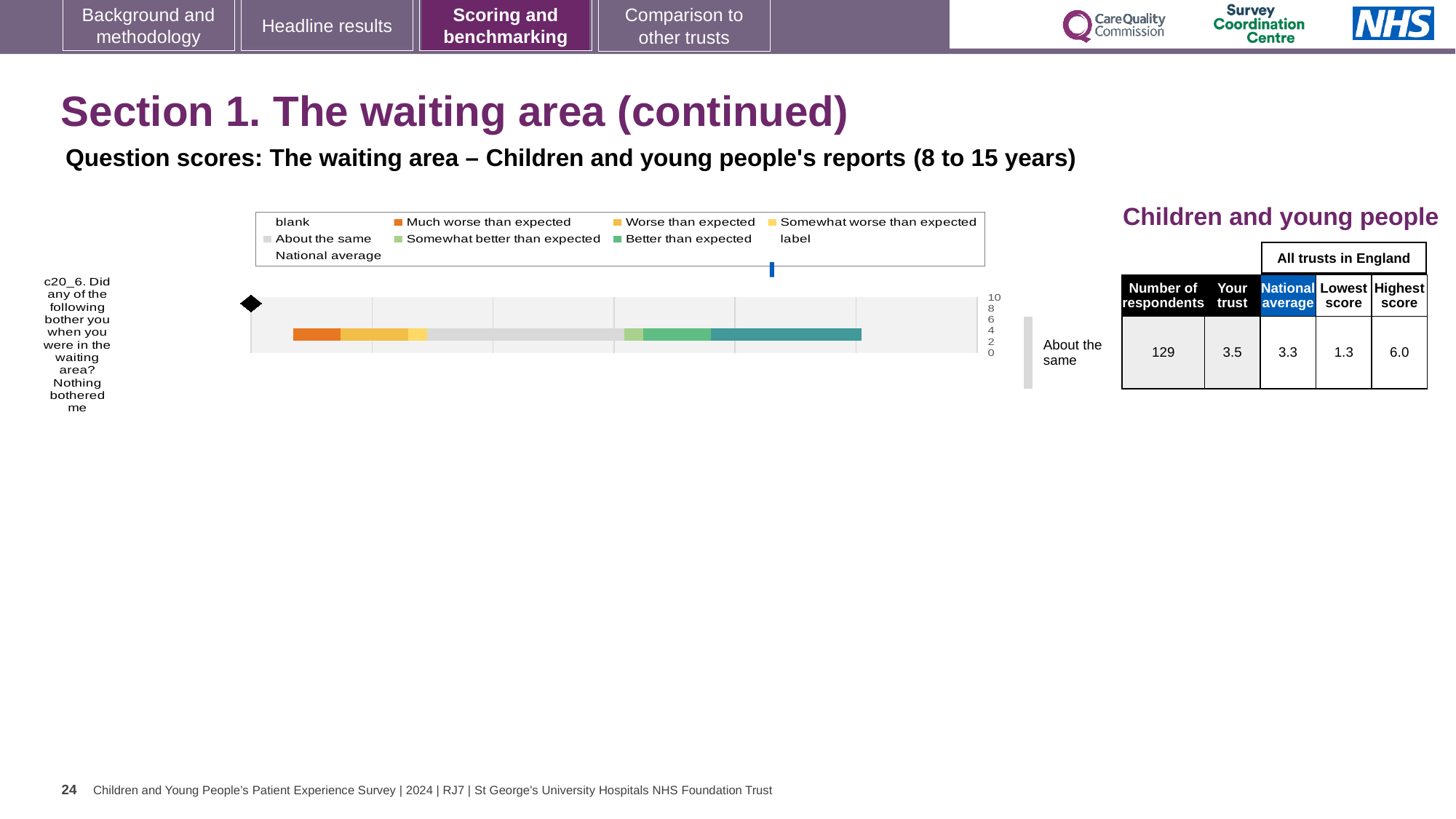
What kind of chart is shown on the slide? Bar chart Which question code is plotted in the bar chart? c20_6 In the table beside the chart, what is the highest score among all trusts in England? 6.0 What benchmark label is shown to the right of the bar for question c20_6? About the same In the table beside the chart, what is the national average score for question c20_6? 3.3 What is the difference between the highest score and the lowest score shown in the table for question c20_6? 4.7 In the table beside the chart, what is the lowest score among all trusts in England? 1.3 In the table beside the chart, how many respondents answered question c20_6? 129 How many questions (categories) are plotted in the bar chart? 1 Which is larger for question c20_6: the 'Your trust' score or the national average? Your trust In the chart legend, what colour represents 'Much worse than expected'? Orange In the table beside the chart, what is the 'Your trust' score for question c20_6? 3.5